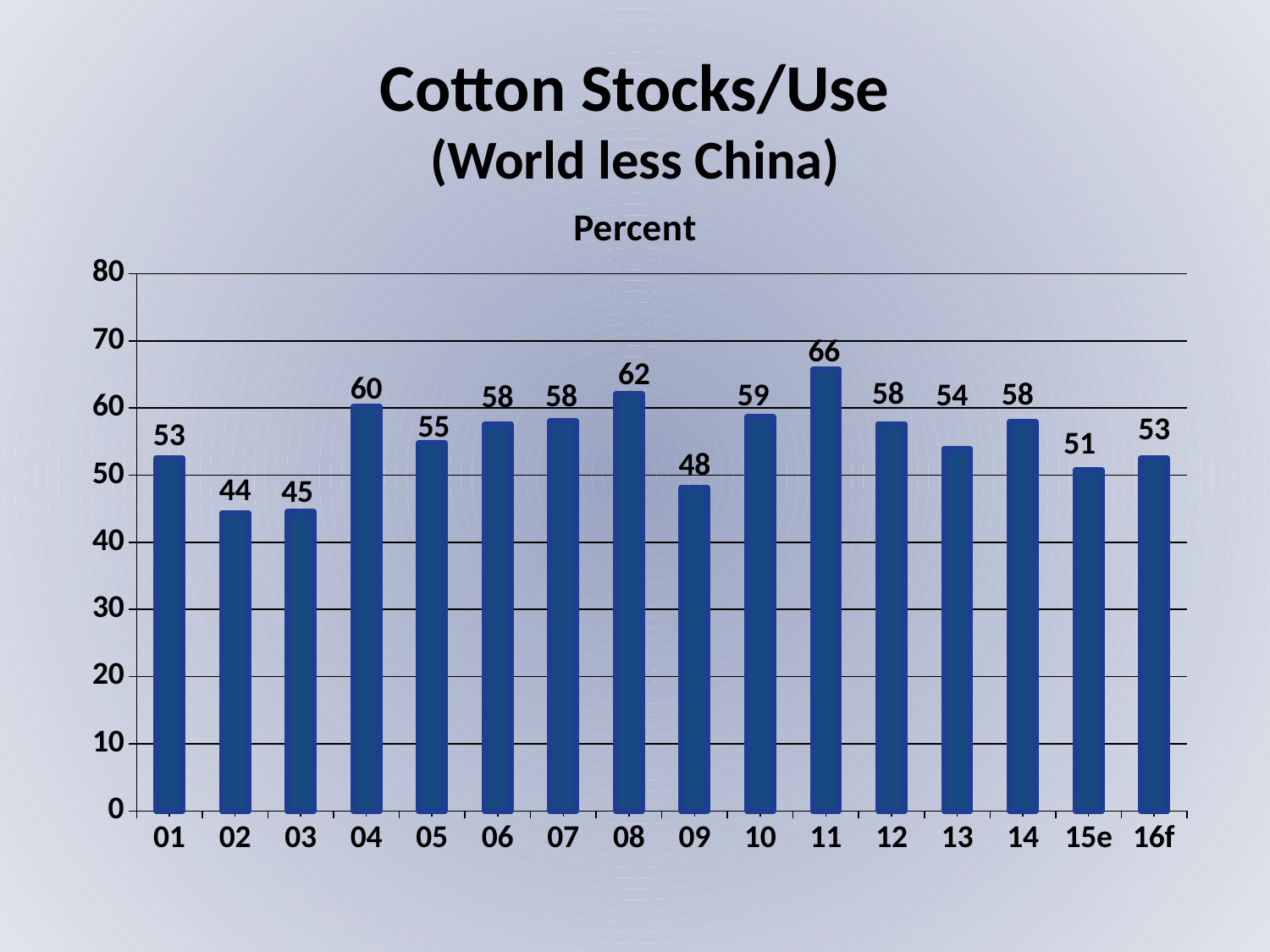
What unit is indicated above the chart? Percent What kind of chart is shown on the slide? bar chart Is the value for 09 greater or less than 50? less How many years are shown on the x axis? 16 Which is larger, the value for 04 or the value for 13? 04 What is the value shown for 02? 44 Which year has the highest stocks/use value? 11 What is the difference between the values for 11 and 09? 18 What is the cotton stocks/use value for 08? 62 Do the values rise or fall from 01 to 02? fall What is the value shown for 15e? 51 Which year has the lowest stocks/use value? 02